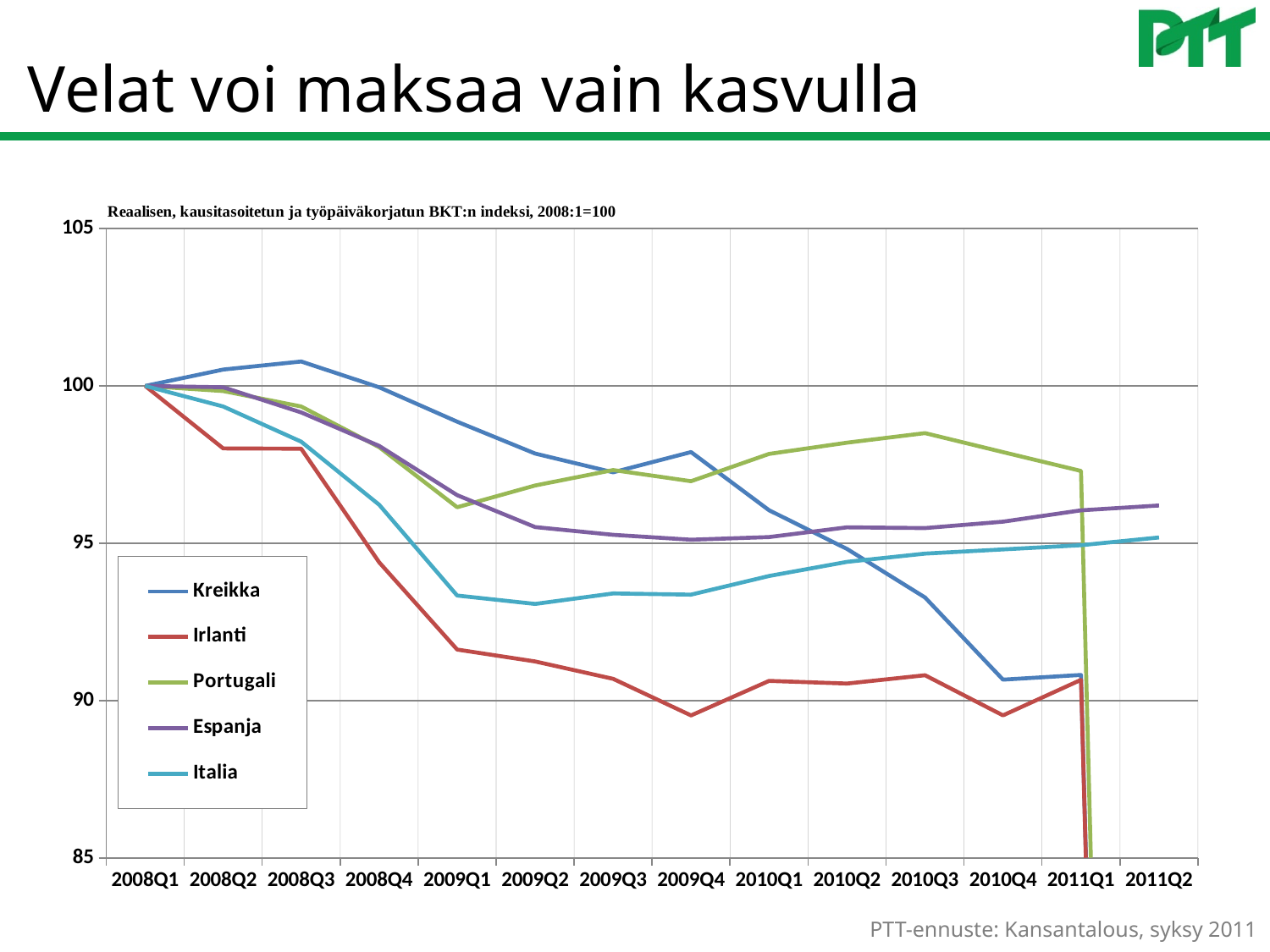
Is the value for Irlanti in 2009Q1 greater or less than 90? greater What is the title printed above the chart? Reaalisen, kausitasoitetun ja työpäiväkorjatun BKT:n indeksi, 2008:1=100 Which series has the lowest value in 2010Q4? Irlanti In 2010Q3, which is higher, Portugali or Kreikka? Portugali Is the value for Italia in 2009Q1 greater or less than 95? less Does the Kreikka line rise or fall from 2009Q4 to 2010Q4? fall What kind of chart is shown on the slide? line chart Is the value for Kreikka in 2009Q1 greater or less than 100? less Which series has the highest value in 2008Q3? Kreikka How many series does the legend list? 5 How many quarters are labelled on the x axis? 14